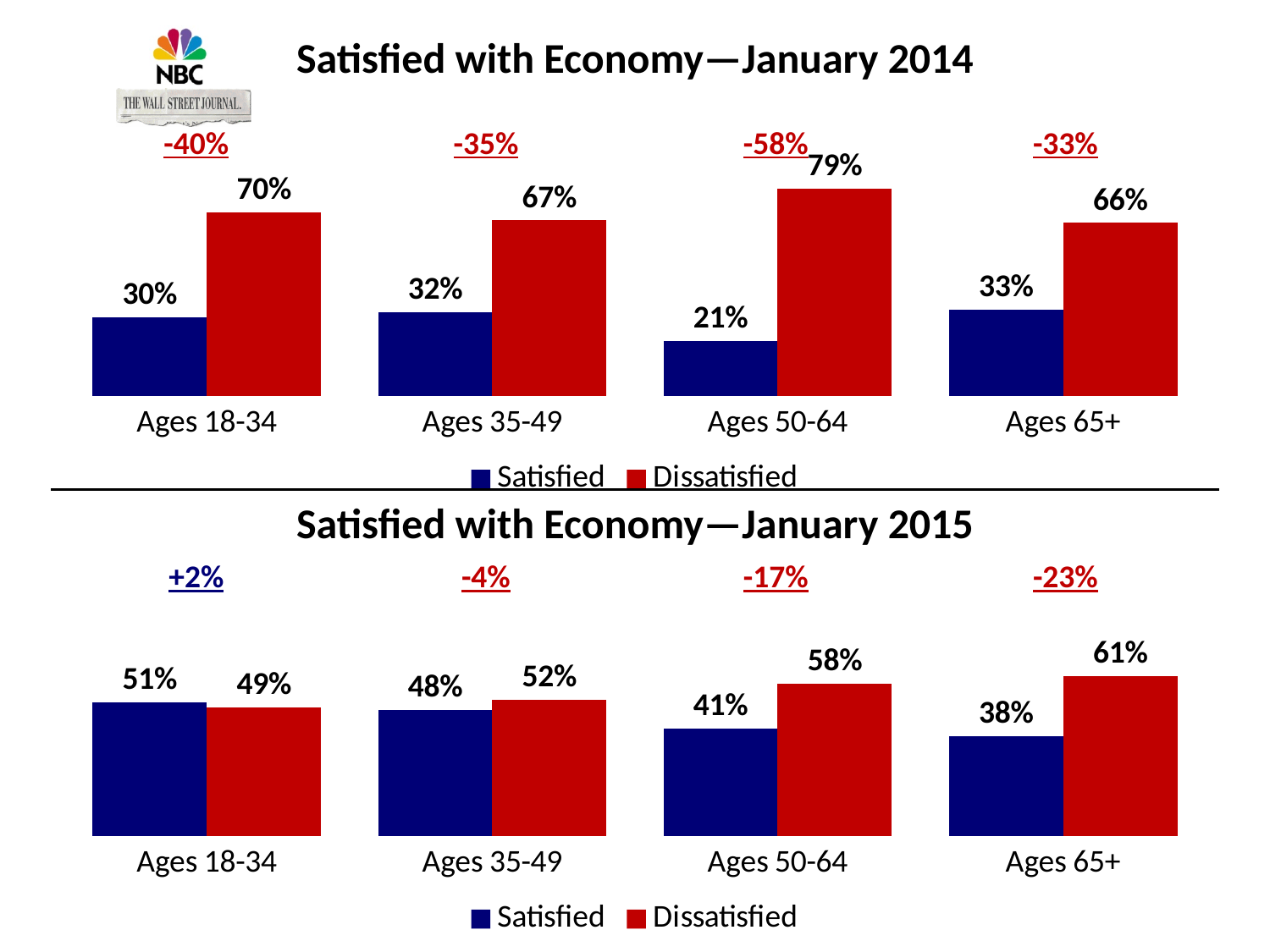
In the 'Satisfied with Economy—January 2014' chart, which age group has the lowest Satisfied value? Ages 50-64 How many series does the legend of the 'Satisfied with Economy—January 2014' chart list? 2 In the 'Satisfied with Economy—January 2015' chart, what is the Satisfied value for Ages 18-34? 51% In the 'Satisfied with Economy—January 2015' chart, which is larger for Ages 35-49, Satisfied or Dissatisfied? Dissatisfied In the 'Satisfied with Economy—January 2015' chart, do the Satisfied values rise or fall from Ages 18-34 to Ages 65+? Fall What kind of chart is the 'Satisfied with Economy—January 2014' chart? Bar chart How many age groups are shown in the 'Satisfied with Economy—January 2015' chart? 4 Which colour represents the Dissatisfied series in the charts? Red In the 'Satisfied with Economy—January 2014' chart, what is the Dissatisfied value for Ages 50-64? 79% In the 'Satisfied with Economy—January 2015' chart, what is the Satisfied value for Ages 65+? 38% In the 'Satisfied with Economy—January 2014' chart, what is the difference between the Dissatisfied and Satisfied values for Ages 18-34? 40% In the 'Satisfied with Economy—January 2015' chart, which age group has the highest Dissatisfied value? Ages 65+